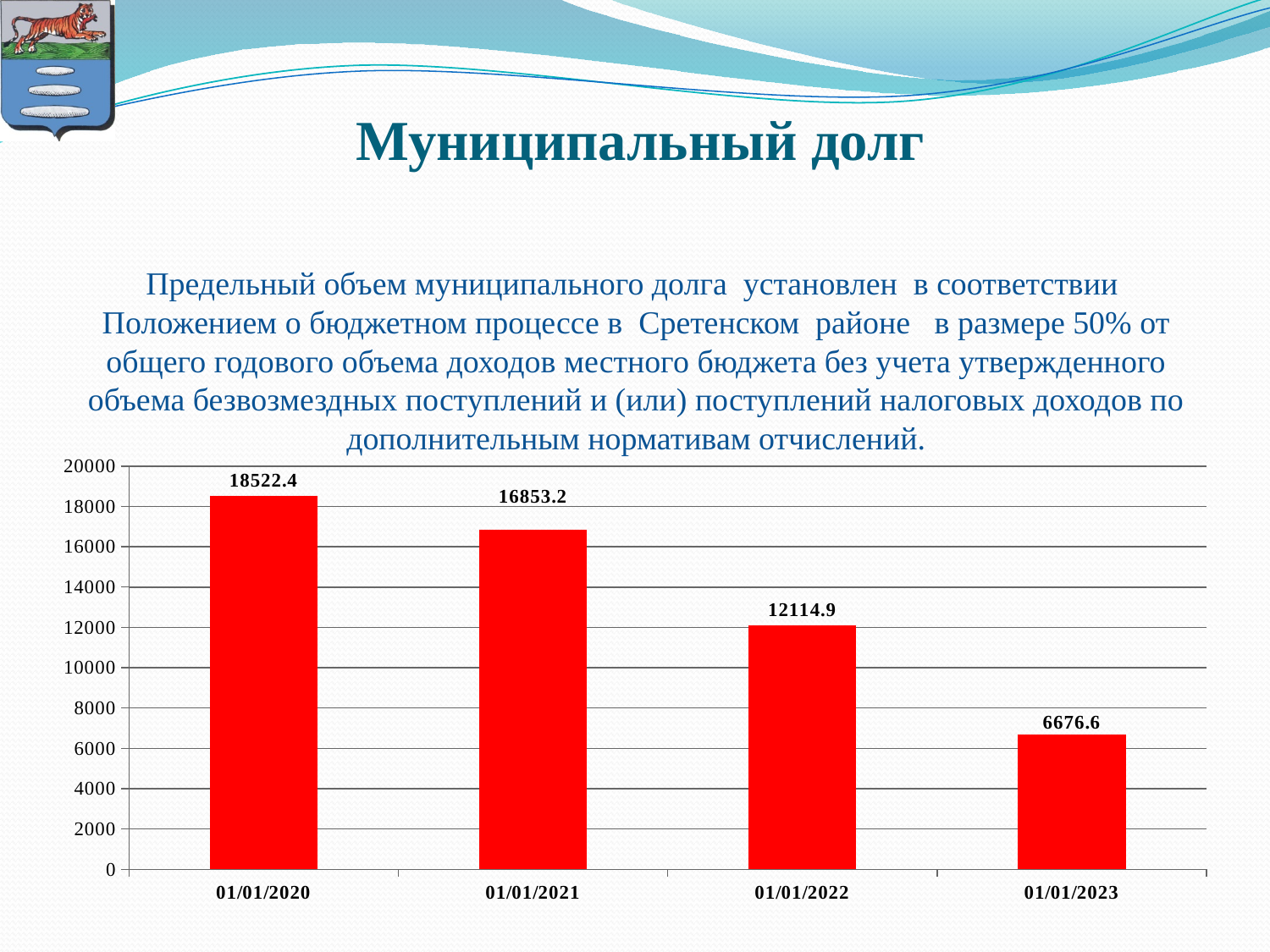
What kind of chart is shown on the slide? bar chart What is the value for 01/01/2022? 12114.9 Which date has the highest value? 01/01/2020 What is the difference between the values for 01/01/2021 and 01/01/2022? 4738.3 What is the value for 01/01/2020? 18522.4 How many dates are shown on the x axis? 4 What is the value for 01/01/2021? 16853.2 Is the value for 01/01/2022 greater or less than 14000? less What is the value for 01/01/2023? 6676.6 What is the difference between the values for 01/01/2020 and 01/01/2023? 11845.8 Which date has the lowest value? 01/01/2023 Which is larger, the value for 01/01/2021 or the value for 01/01/2022? 01/01/2021